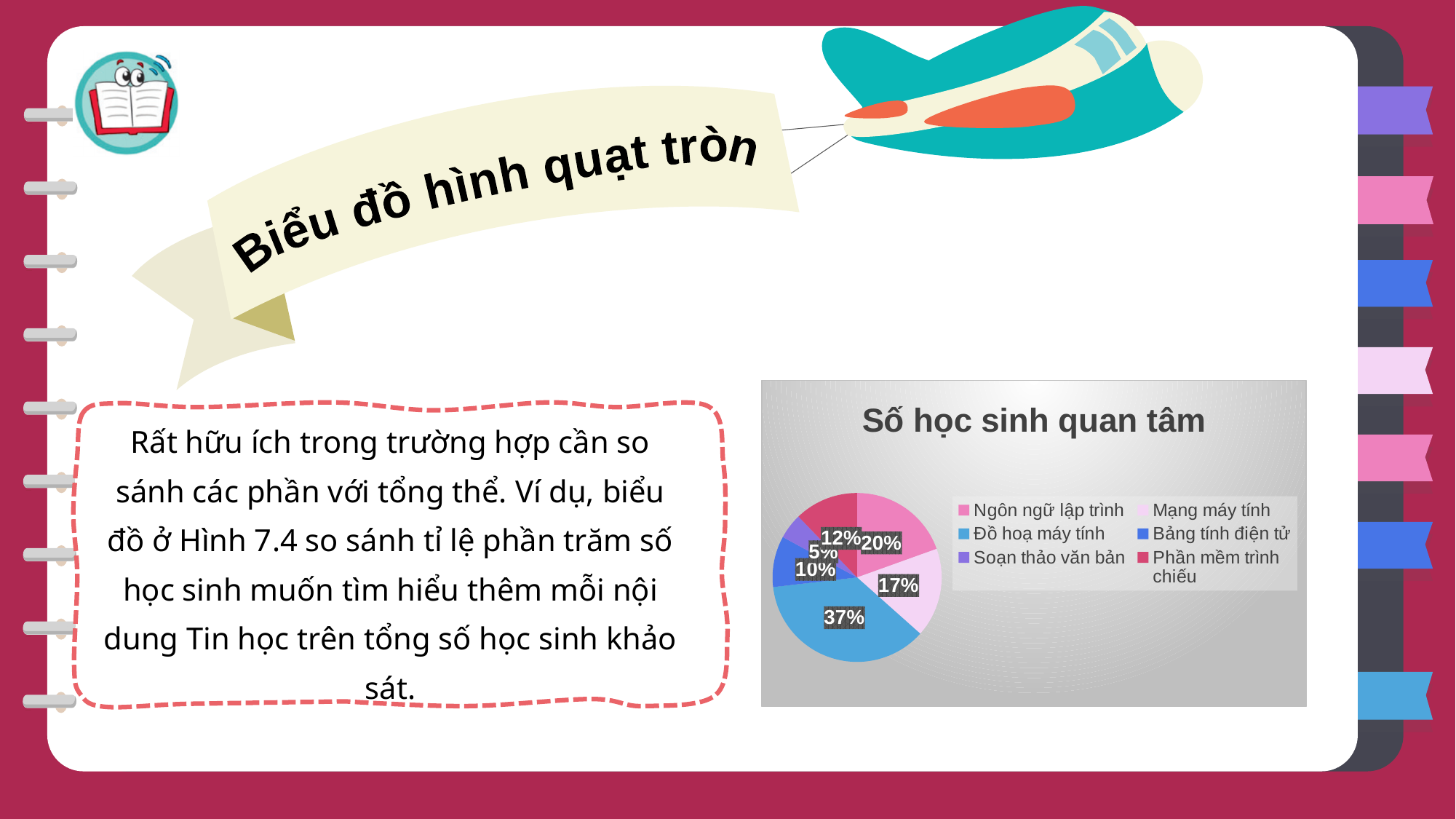
Which is larger, the share for Bảng tính điện tử or the share for Phần mềm trình chiếu? Phần mềm trình chiếu What percentage of the pie is Mạng máy tính? 17% What percentage of the pie is Ngôn ngữ lập trình? 20% What percentage of the pie is Phần mềm trình chiếu? 12% What is the title of the chart? Số học sinh quan tâm What kind of chart is shown on the slide? pie chart What is the difference between the shares of Đồ hoạ máy tính and Ngôn ngữ lập trình? 17% What percentage of the pie is Đồ hoạ máy tính? 37% Which category has the largest share of the pie? Đồ hoạ máy tính How many categories does the pie chart have? 6 Which category has the smallest share of the pie? Soạn thảo văn bản What percentage of the pie is Soạn thảo văn bản? 5%